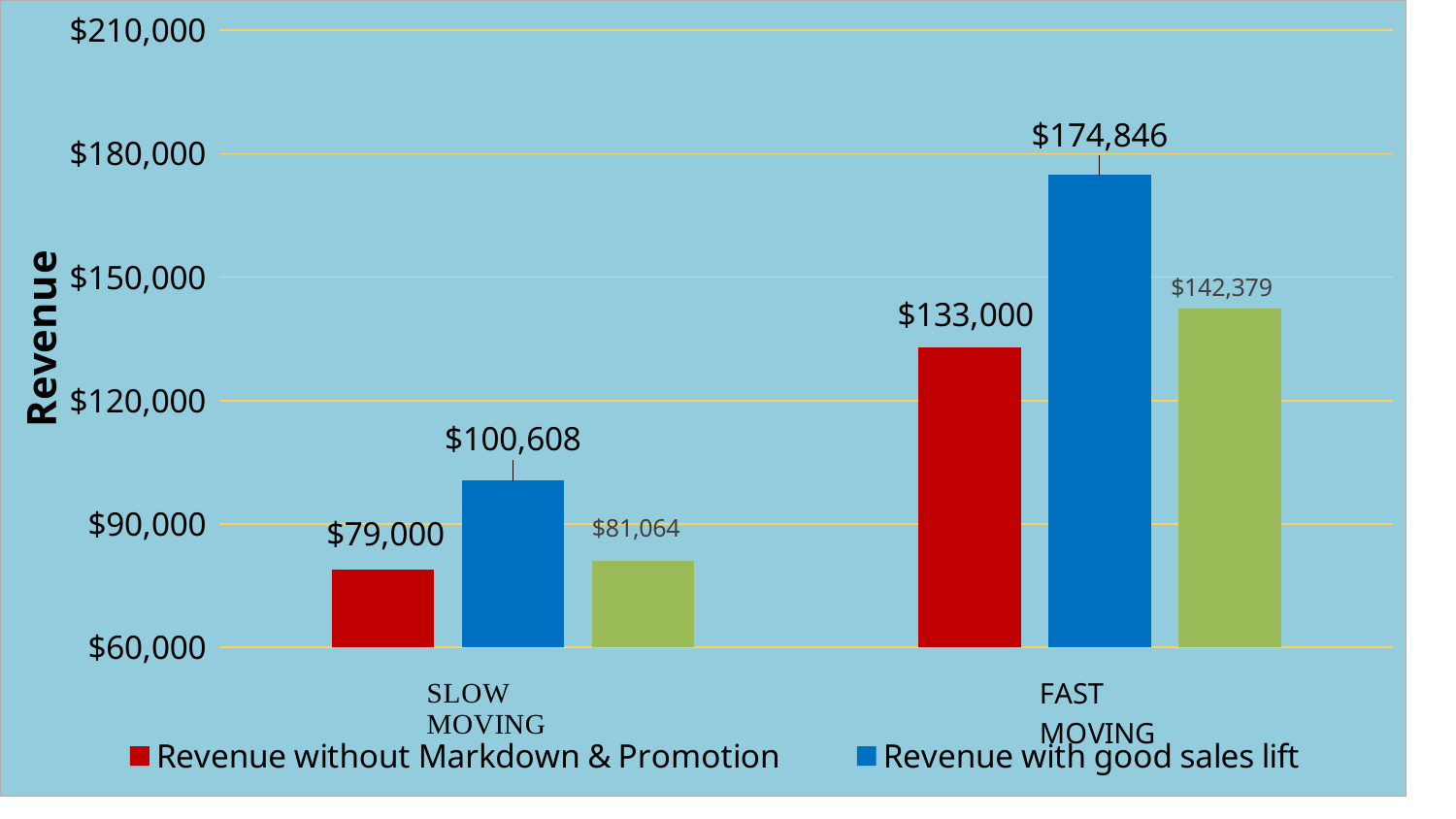
Which is larger for SLOW MOVING: Revenue with good sales lift or Revenue without Markdown & Promotion? Revenue with good sales lift What is the Revenue without Markdown & Promotion for SLOW MOVING? $79,000 What value is shown on the green bar for FAST MOVING? $142,379 What type of chart is shown on the slide? Bar chart Which bar on the chart has the lowest value? Revenue without Markdown & Promotion for SLOW MOVING What is the Revenue without Markdown & Promotion for FAST MOVING? $133,000 Which bar on the chart has the highest value? Revenue with good sales lift for FAST MOVING What is the difference between Revenue with good sales lift and Revenue without Markdown & Promotion for FAST MOVING? $41,846 What is the Revenue with good sales lift for SLOW MOVING? $100,608 How many series does the legend list? 2 What is the Revenue with good sales lift for FAST MOVING? $174,846 How many categories are shown on the x axis? 2